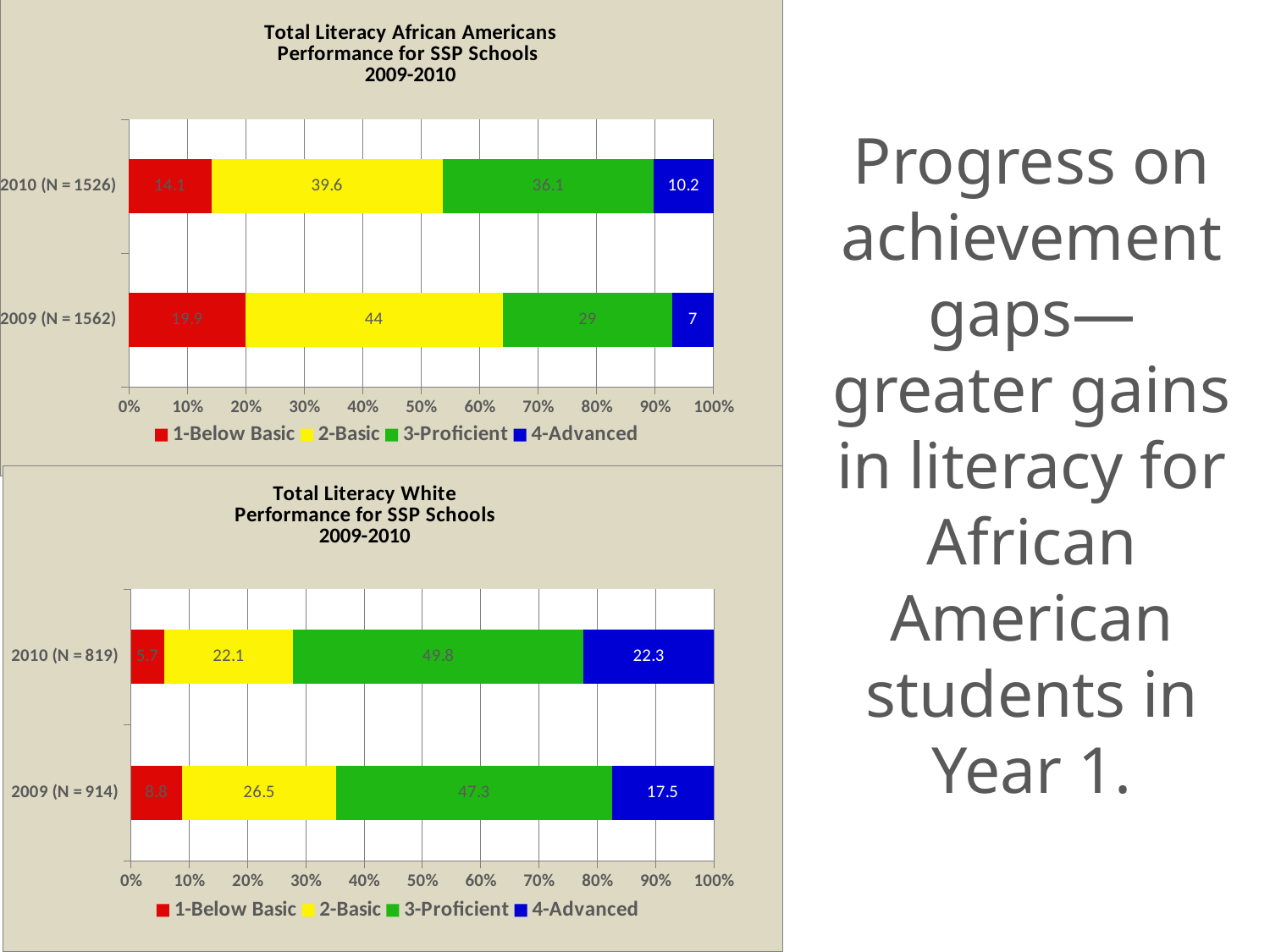
In the Total Literacy White chart, what is the value for 2-Basic in 2009 (N = 914)? 26.5 In the Total Literacy African Americans chart, what is the value for 3-Proficient in 2010 (N = 1526)? 36.1 In the Total Literacy White chart, what is the value for 4-Advanced in 2010 (N = 819)? 22.3 In the Total Literacy White chart, what is the difference between the 3-Proficient values for 2010 and 2009? 2.5 In the Total Literacy White chart, which segment is the largest in the 2010 (N = 819) bar? 3-Proficient In the Total Literacy African Americans chart, which segment is the smallest in the 2009 (N = 1562) bar? 4-Advanced In the Total Literacy White chart, what is the total of the 2009 (N = 914) bar? 100.1 What type of chart is the Total Literacy African Americans chart? Stacked bar chart In the Total Literacy African Americans chart, which year has the larger 2-Basic value, 2010 or 2009? 2009 In the Total Literacy African Americans chart, what is the difference between the 4-Advanced values for 2010 and 2009? 3.2 In the Total Literacy African Americans chart, what is the value for 1-Below Basic in 2009 (N = 1562)? 19.9 How many series does the legend of the Total Literacy White chart list? 4